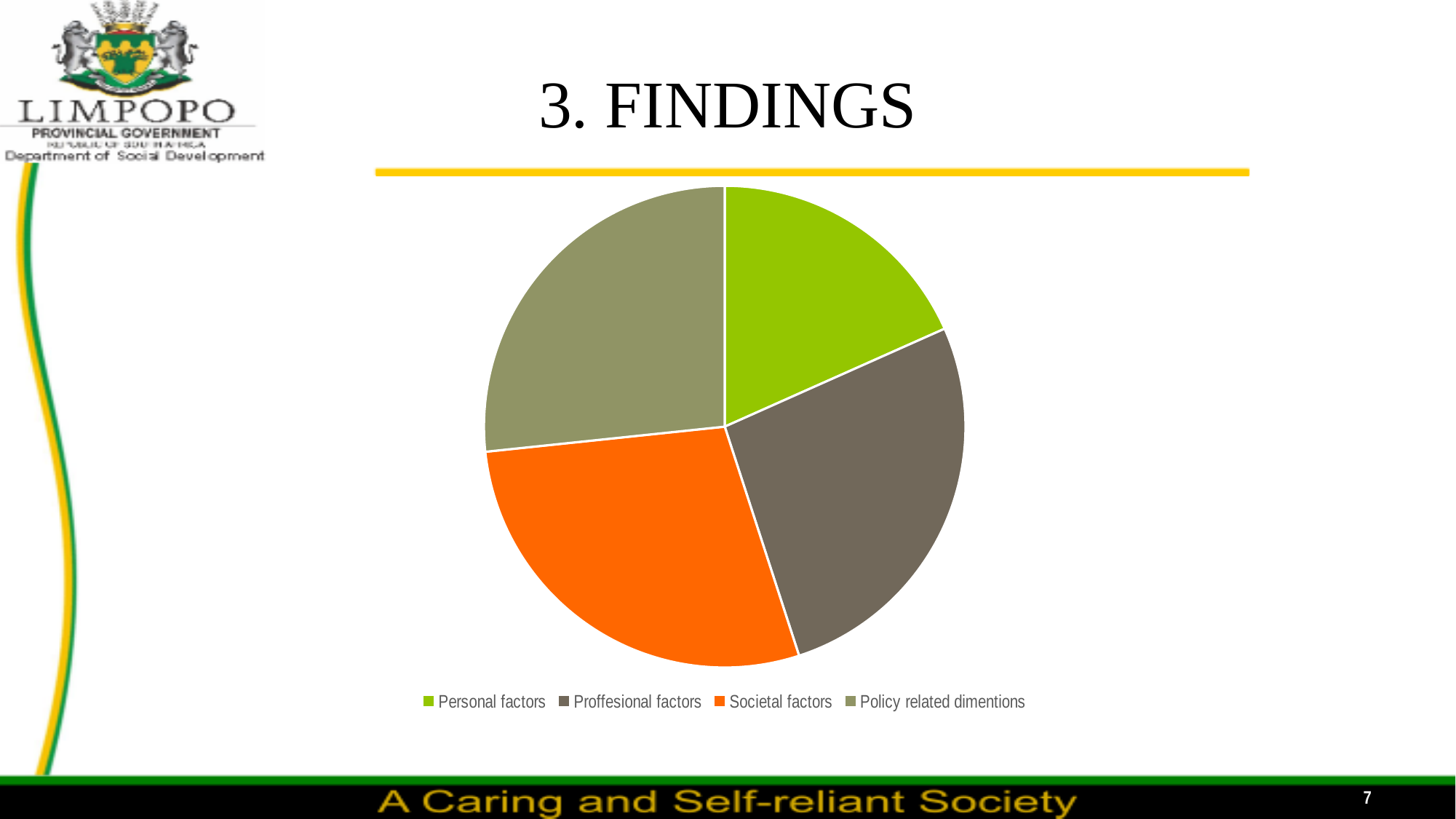
How many slices does the pie chart have? 4 Which legend entry is shown in bright green? Personal factors Which slice is larger, Policy related dimentions or Personal factors? Policy related dimentions Which slice is larger, Personal factors or Proffesional factors? Proffesional factors How many entries does the legend of the pie chart list? 4 What kind of chart is shown on the slide? Pie chart Which slice is larger, Personal factors or Societal factors? Societal factors Which category has the smallest slice in the pie chart? Personal factors What colour is the Societal factors slice in the pie chart? Orange